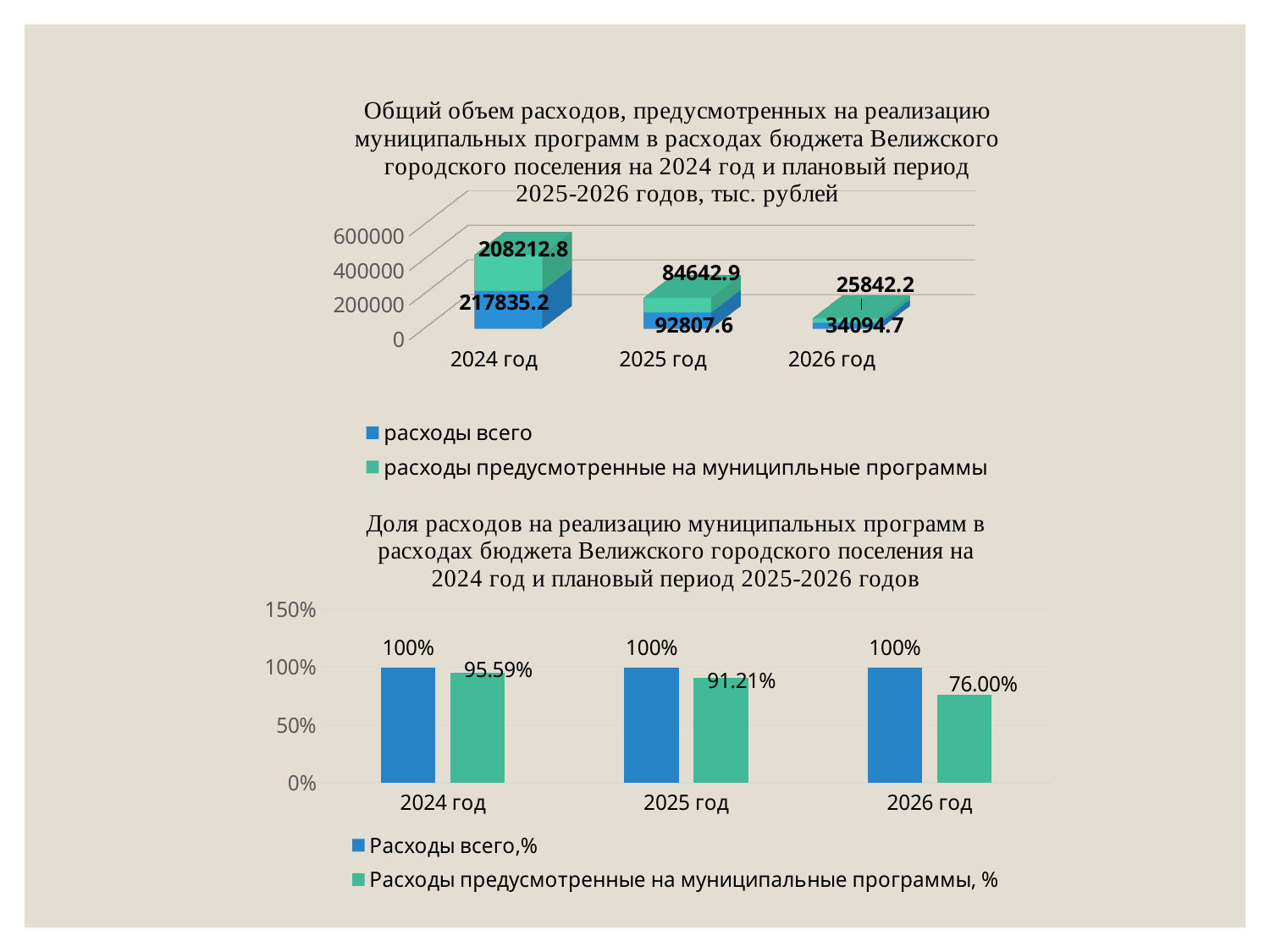
In the top chart, what is the value of 'расходы предусмотренные на муниципльные программы' for 2025 год? 84642.9 In the bottom chart, what is the value of 'Расходы предусмотренные на муниципальные программы, %' for 2026 год? 76.00% In the top chart, do the values for 'расходы всего' rise or fall from 2024 год to 2026 год? fall In the bottom chart, what is the difference between 'Расходы всего,%' and 'Расходы предусмотренные на муниципальные программы, %' for 2025 год? 8.79% In the top chart, which year has the lowest value for 'расходы всего'? 2026 год In the top chart, what is the value of 'расходы предусмотренные на муниципльные программы' for 2026 год? 25842.2 In the top chart, how many series does the legend list? 2 In the bottom chart, what is the value of 'Расходы предусмотренные на муниципальные программы, %' for 2024 год? 95.59% In the top chart, what is the difference between 'расходы всего' and 'расходы предусмотренные на муниципльные программы' for 2025 год? 8164.7 What kind of chart is the bottom chart? bar chart In the bottom chart, which year has the lowest value for 'Расходы предусмотренные на муниципальные программы, %'? 2026 год In the top chart, what is the value of 'расходы всего' for 2024 год? 217835.2